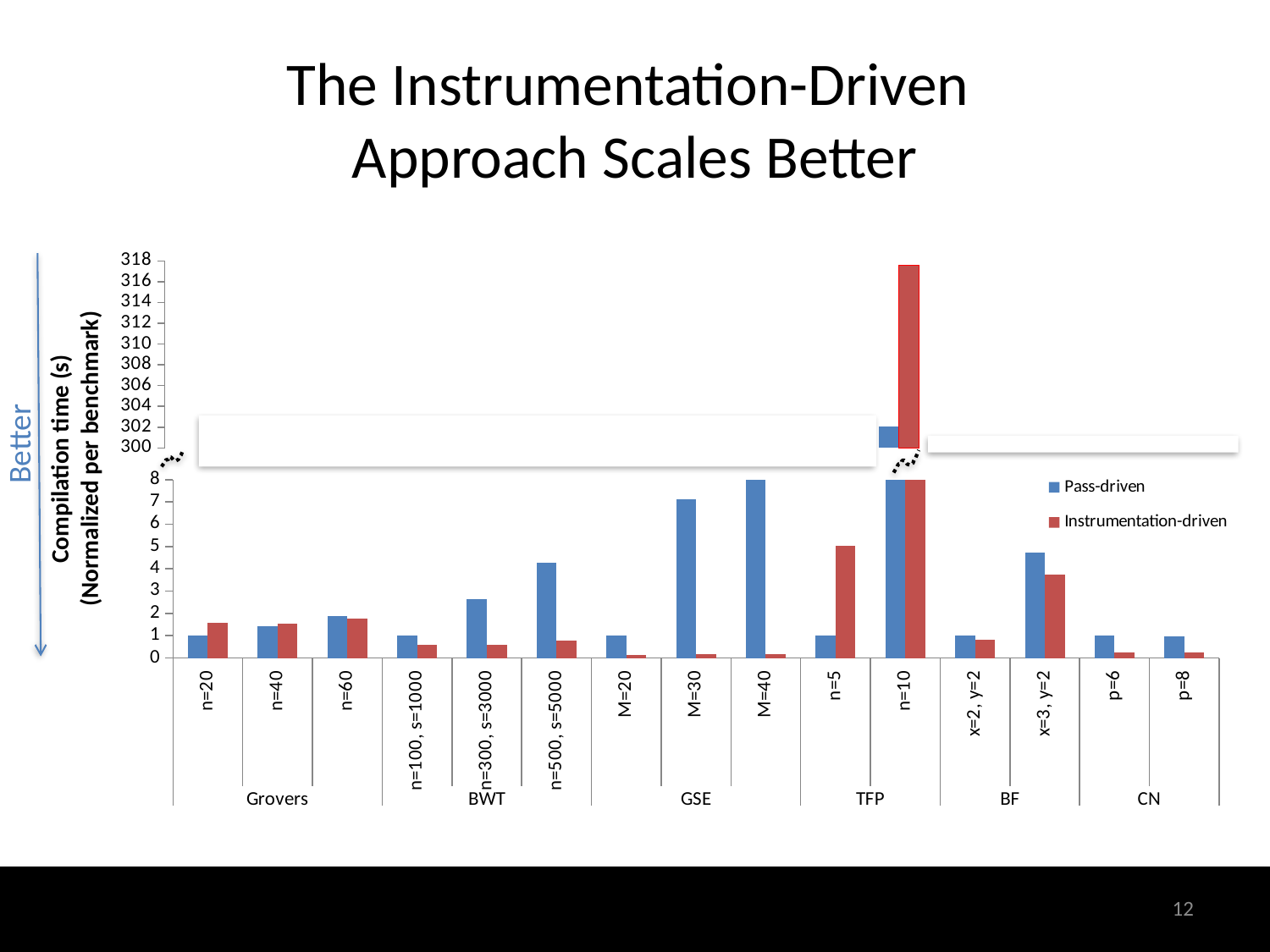
What are the two series named in the legend? Pass-driven and Instrumentation-driven For M=40 (GSE), which series has the larger value, Pass-driven or Instrumentation-driven? Pass-driven For n=5 (TFP), which series has the larger value, Pass-driven or Instrumentation-driven? Instrumentation-driven Which parameter setting has the highest Instrumentation-driven value? n=10 (TFP) How many bar groups (parameter settings) are plotted along the x axis? 15 How many benchmark groups are labelled along the x axis (Grovers, BWT, etc.)? 6 What is the title of the y axis? Compilation time (s) (Normalized per benchmark) Is the Pass-driven value for M=30 (GSE) greater or less than 6? greater How many series does the legend list? 2 What kind of chart is shown on the slide? bar chart Is the Instrumentation-driven value for n=10 (TFP) greater or less than 310? greater Is the Instrumentation-driven value for n=300, s=3000 (BWT) greater or less than 1? less